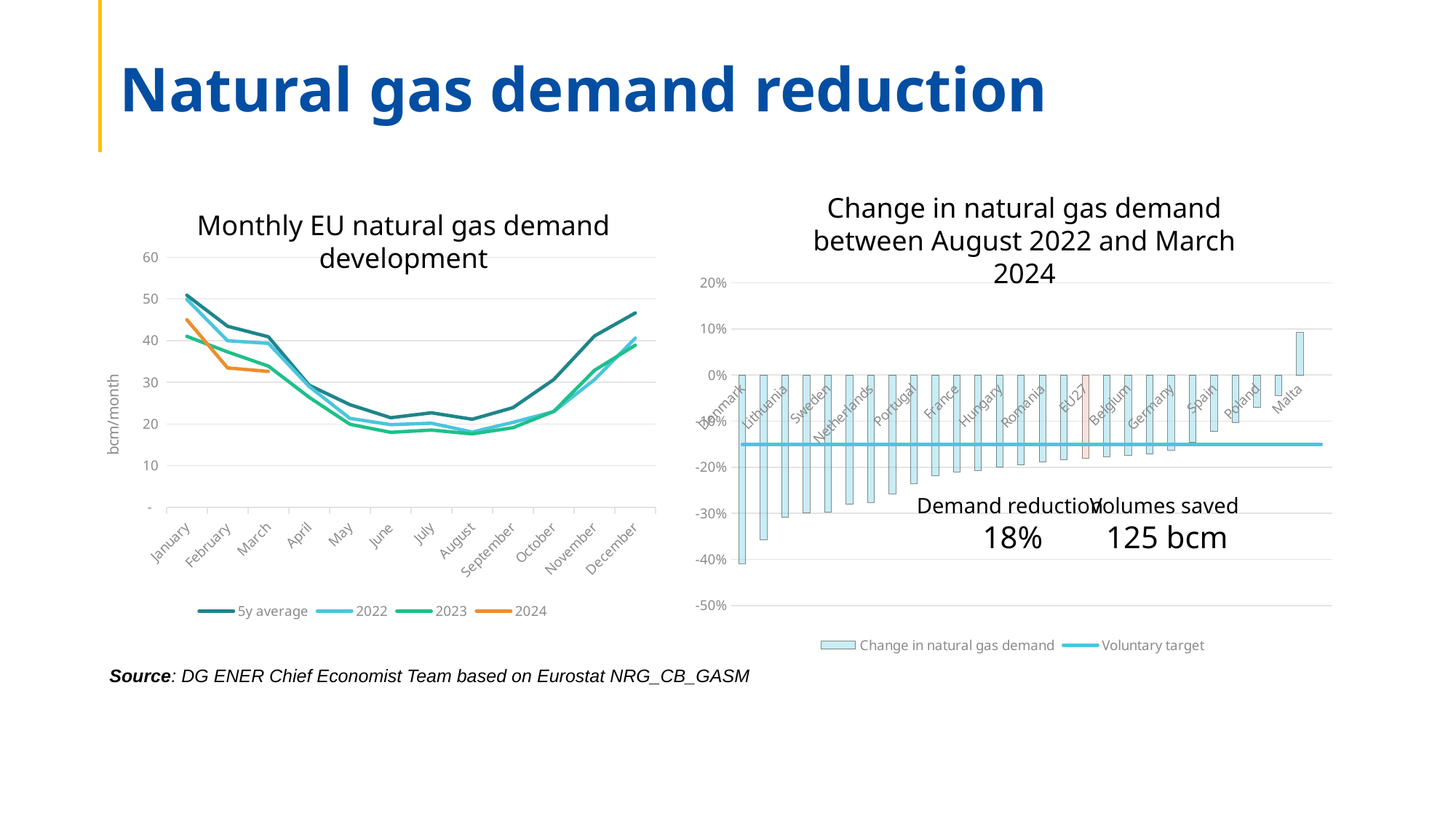
In the 'Change in natural gas demand between August 2022 and March 2024' chart, which country has the highest value? Malta How many series does the legend of the 'Monthly EU natural gas demand development' chart list? 4 In the 'Change in natural gas demand between August 2022 and March 2024' chart, is the value for Denmark greater or less than -30%? less In the 'Monthly EU natural gas demand development' chart, does the 5y average line rise or fall from January to June? fall How many entries does the legend of the 'Change in natural gas demand between August 2022 and March 2024' chart list? 2 What kind of chart is the 'Change in natural gas demand between August 2022 and March 2024' chart? combination bar and line chart How many months are shown on the x axis of the 'Monthly EU natural gas demand development' chart? 12 What demand reduction percentage is printed on the 'Change in natural gas demand between August 2022 and March 2024' chart? 18% What kind of chart is the 'Monthly EU natural gas demand development' chart? line chart In the 'Change in natural gas demand between August 2022 and March 2024' chart, which country has the lowest value (largest reduction)? Denmark In the 'Monthly EU natural gas demand development' chart, is the 5y average value for January greater or less than 40? greater In the 'Monthly EU natural gas demand development' chart, is the 2023 value for June greater or less than 20? less